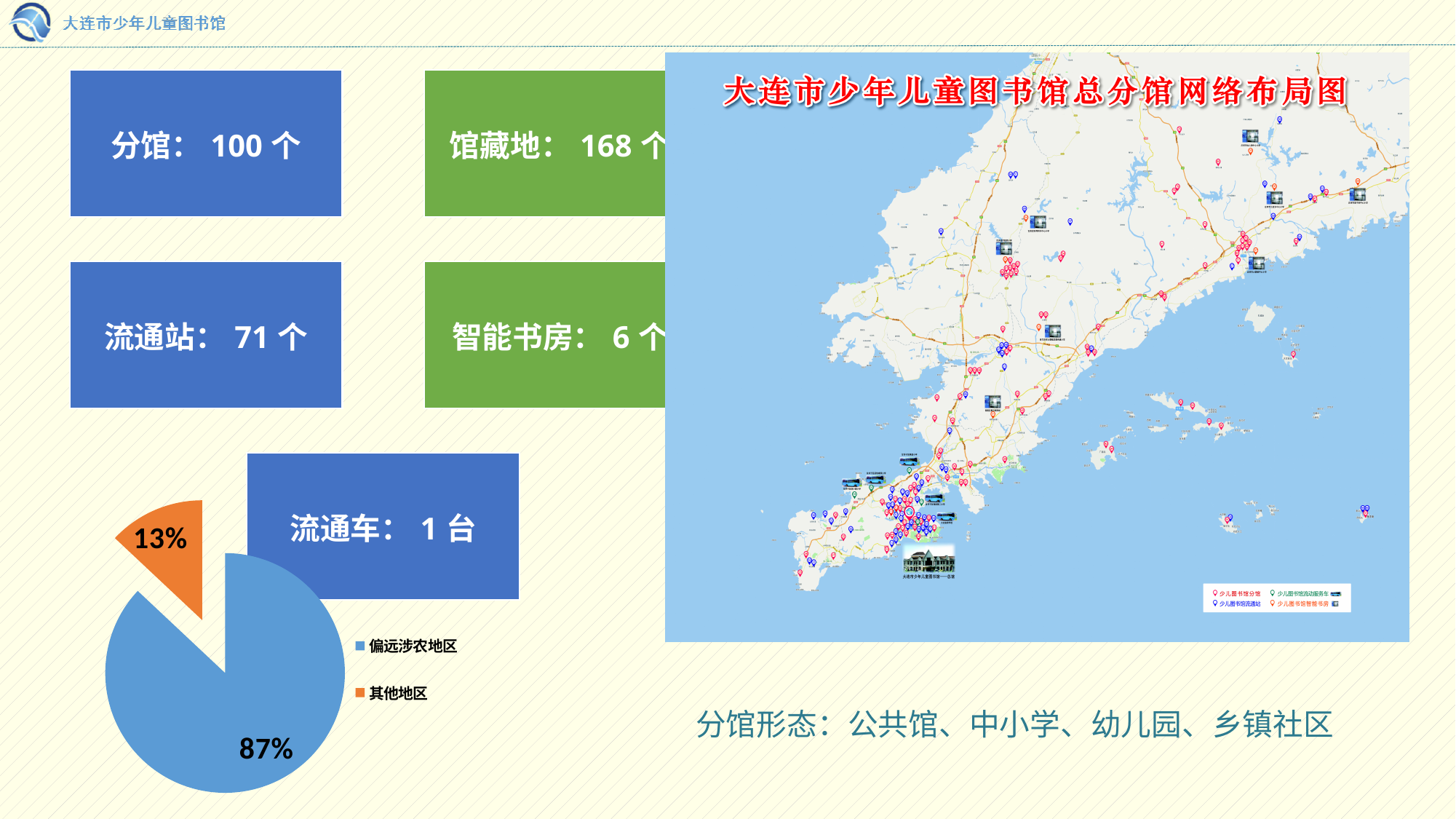
Which slice of the pie chart is the largest? 偏远涉农地区 In the pie chart, what share does 其他地区 have? 13% What colour is the 偏远涉农地区 slice in the pie chart? blue What is the difference in percentage points between 偏远涉农地区 and 其他地区 in the pie chart? 74 Which slice of the pie chart is the smallest? 其他地区 In the pie chart, what share does 偏远涉农地区 have? 87% In the pie chart, which is larger: 偏远涉农地区 or 其他地区? 偏远涉农地区 How many slices does the pie chart have? 2 What colour is the 其他地区 slice in the pie chart? orange How many entries does the pie chart's legend list? 2 What kind of chart is shown at the bottom left of the slide? pie chart